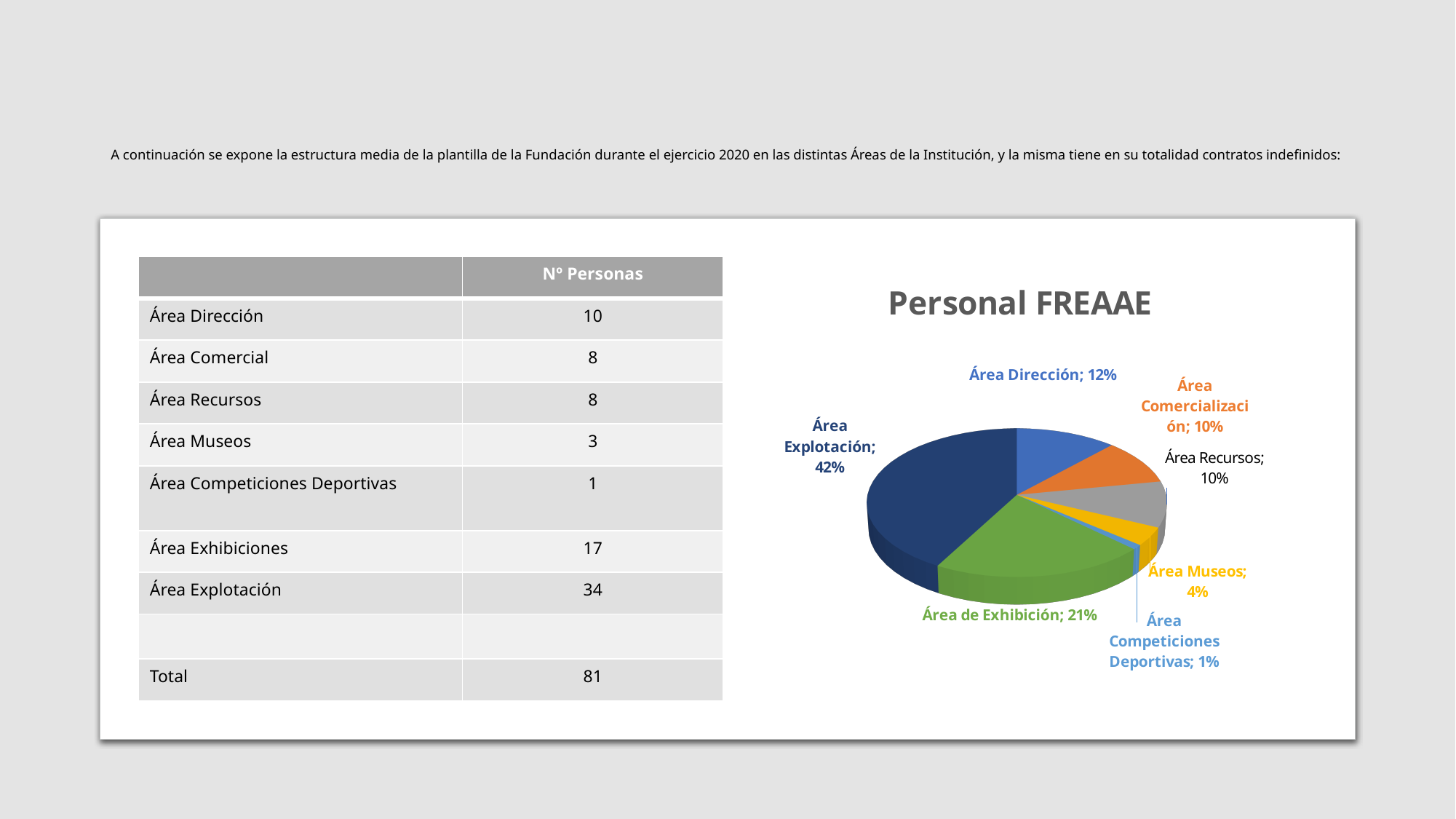
What percentage is shown for Área de Exhibición? 21% What is the title of the chart? Personal FREAAE What share of the pie does Área Explotación represent? 42% What type of chart is shown on the slide? pie chart What percentage is shown for Área Competiciones Deportivas? 1% Which slice of the pie is the smallest? Área Competiciones Deportivas How many slices does the pie chart have? 7 What is the difference in percentage points between Área Explotación and Área de Exhibición? 21 Which slice of the pie is the largest? Área Explotación What percentage is shown for Área Dirección? 12% Which is larger, the share for Área Dirección or the share for Área Recursos? Área Dirección What percentage is shown for Área Museos? 4%